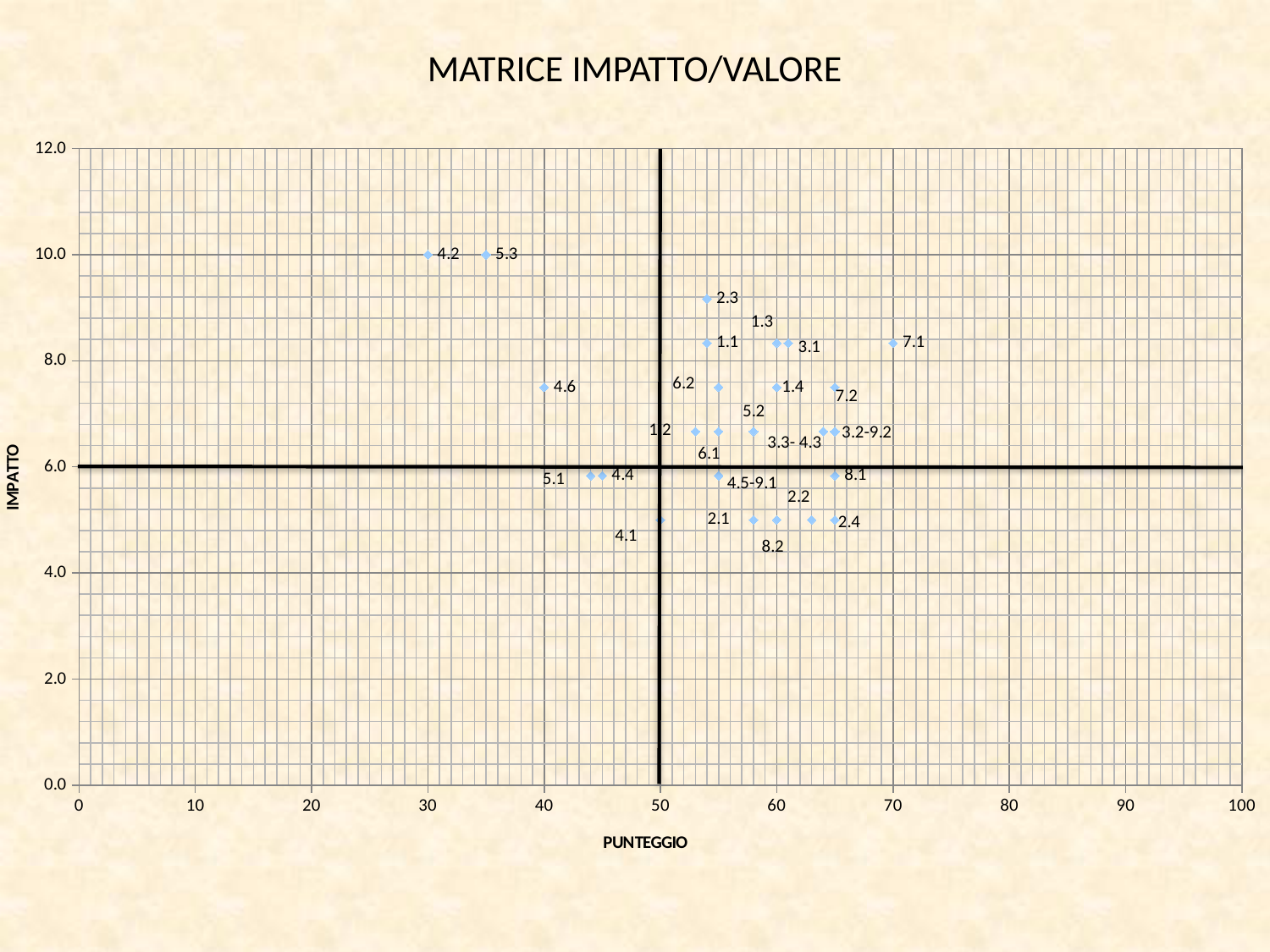
Is the IMPATTO value for point 2.4 greater or less than 6.0? less What kind of chart is shown on the slide? scatter chart Which point has the lowest PUNTEGGIO? 4.2 Is the IMPATTO value for point 2.3 greater or less than 8.0? greater What IMPATTO value does point 4.2 have? 10.0 Which point has the highest PUNTEGGIO? 7.1 What PUNTEGGIO value does point 4.6 have? 40 What is the title of the horizontal axis? PUNTEGGIO What PUNTEGGIO value does point 4.2 have? 30 What PUNTEGGIO value does point 7.1 have? 70 What is the title of the chart? MATRICE IMPATTO/VALORE Which point has the higher IMPATTO, 2.3 or 4.6? 2.3